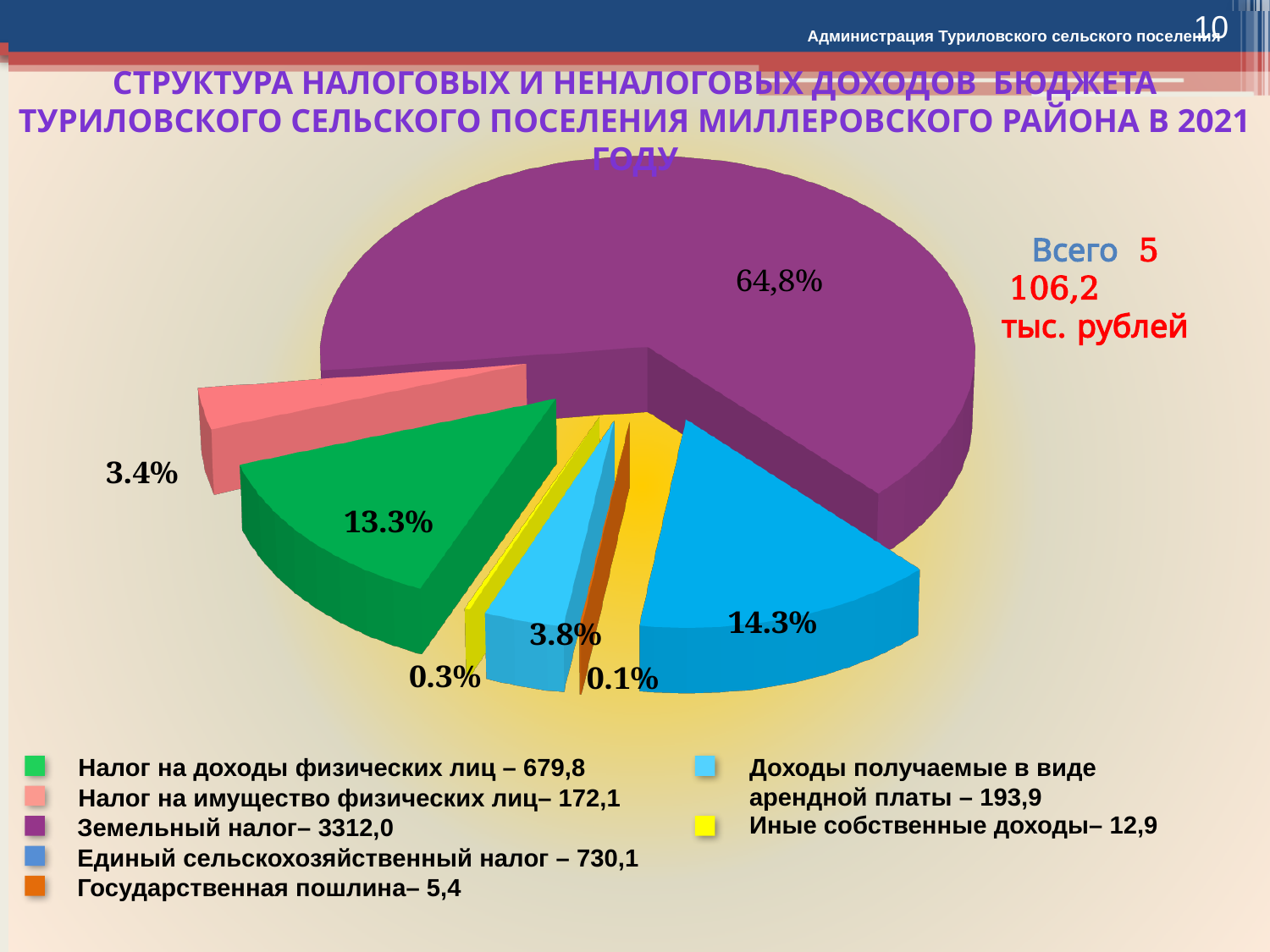
What is the smallest percentage shown on the pie? 0.1% According to the legend, what is the value for Государственная пошлина? 5,4 According to the legend, what is the value for Налог на доходы физических лиц? 679,8 What kind of chart is shown on the slide? pie chart What is the difference between Единый сельскохозяйственный налог (730,1) and Налог на доходы физических лиц (679,8)? 50,3 What percentage is shown on the green slice? 13.3% Which is larger: Налог на доходы физических лиц or Единый сельскохозяйственный налог? Единый сельскохозяйственный налог What total (Всего) is stated on the slide? 5 106,2 тыс. рублей How many categories does the legend list? 7 According to the legend, what is the value for Земельный налог? 3312,0 Which category has the largest slice of the pie? Земельный налог What share of the pie does the largest slice (Земельный налог) have? 64,8%